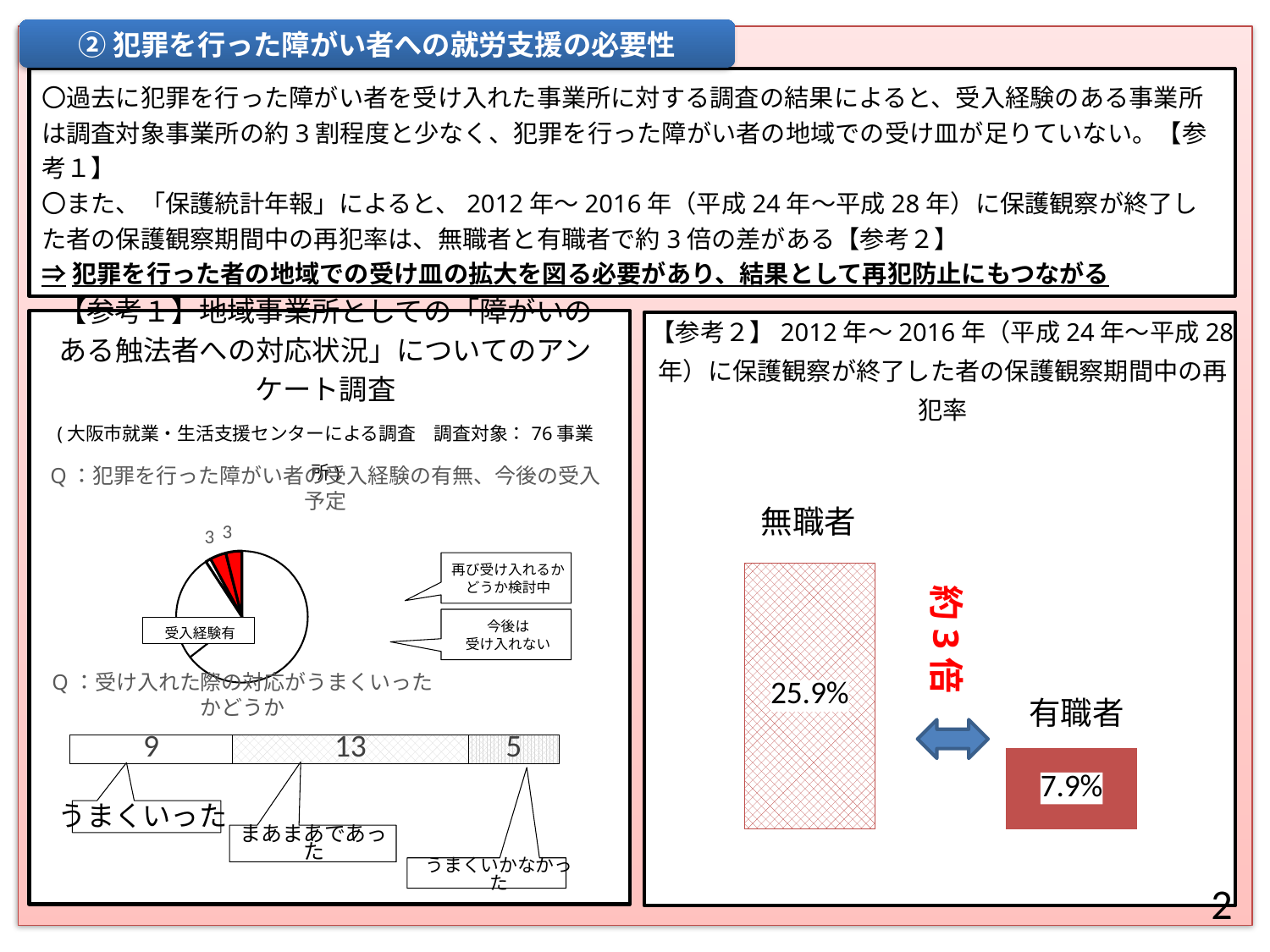
In the stacked bar chart at the bottom left (受け入れた際の対応がうまくいったかどうか), what is the value for まあまあであった? 13 In the 【参考２】 chart on the right, what is the recidivism rate for 無職者? 25.9% In the stacked bar chart at the bottom left (受け入れた際の対応がうまくいったかどうか), what is the value for うまくいった? 9 In the stacked bar chart at the bottom left (受け入れた際の対応がうまくいったかどうか), which response has the lowest value? うまくいかなかった In the 【参考２】 chart on the right, what is the recidivism rate for 有職者? 7.9% In the 【参考２】 chart on the right, what ratio is written in red between the two bars? 約３倍 In the 【参考２】 chart on the right, which group has the higher recidivism rate, 無職者 or 有職者? 無職者 What kind of chart is the 【参考２】 chart on the right? Bar chart In the 【参考２】 chart on the right, what is the difference between the recidivism rates of 無職者 and 有職者? 18.0 percentage points In the 【参考２】 chart on the right, how many groups are plotted? 2 In the stacked bar chart at the bottom left (受け入れた際の対応がうまくいったかどうか), what is the total of the three segments? 27